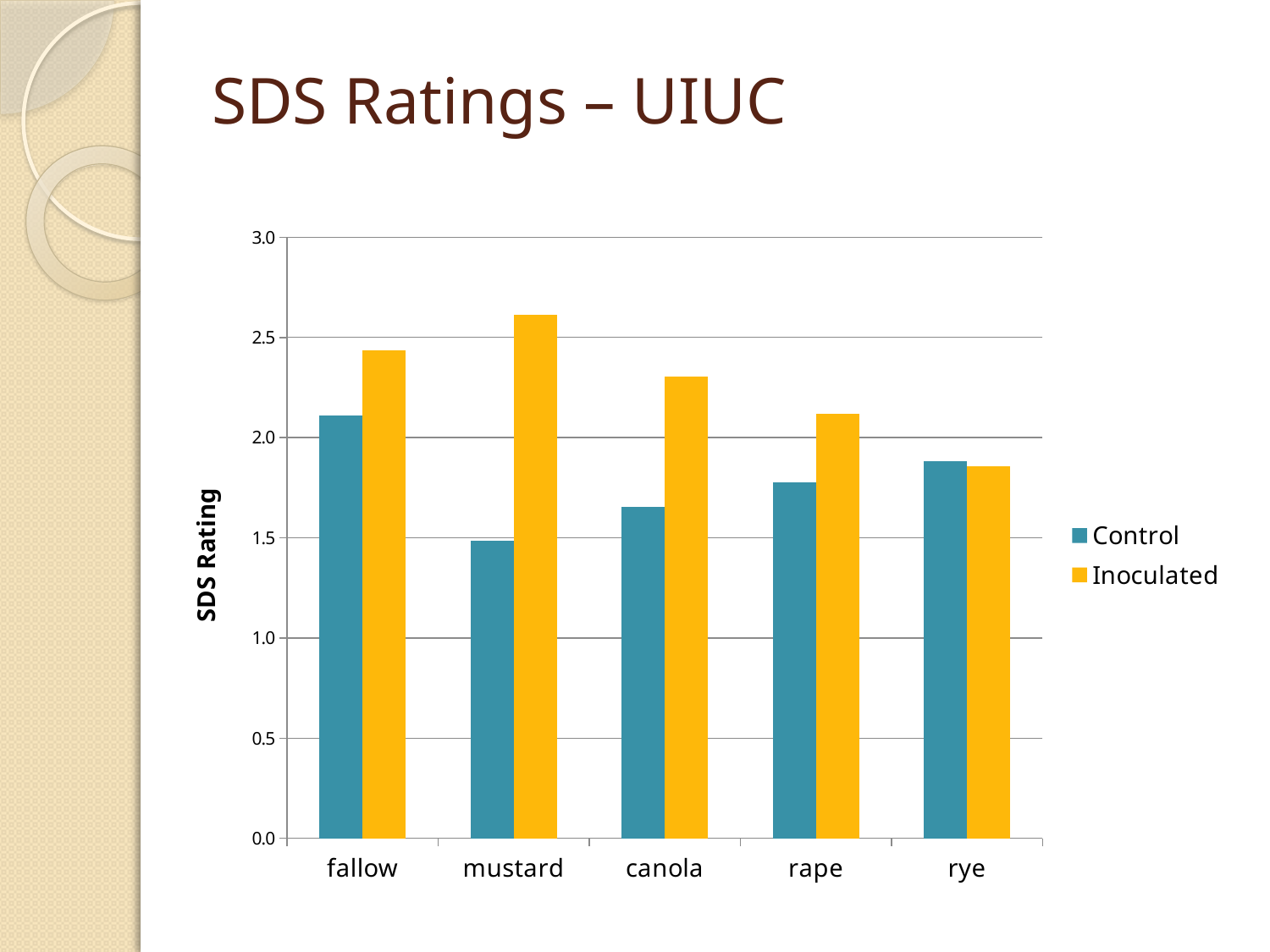
What kind of chart is shown on the slide? bar chart How many series does the legend list? 2 Is the Inoculated value for mustard greater or less than 2.5? greater How many categories are shown on the x axis? 5 Is the Inoculated value for canola greater or less than 2.0? greater Which category has the highest Inoculated value? mustard Is the Control value for rape greater or less than 2.0? less Which category has the lowest Inoculated value? rye Which category has the highest Control value? fallow For mustard, which is larger, the Control value or the Inoculated value? Inoculated What is the label on the vertical axis? SDS Rating Which category has the lowest Control value? mustard